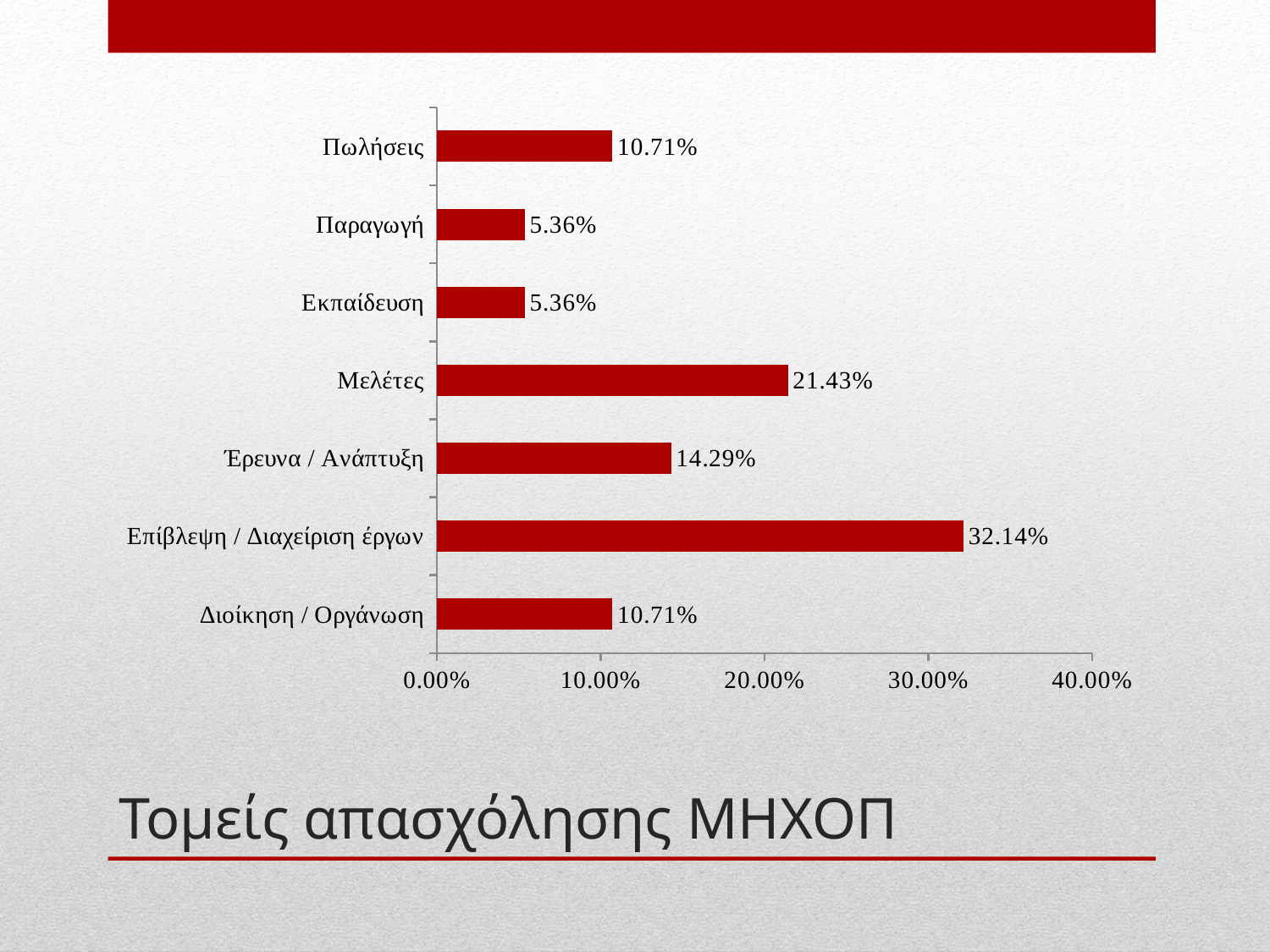
Which is larger, the value for Μελέτες or the value for Έρευνα / Ανάπτυξη? Μελέτες What is the value for Μελέτες? 21.43% Which category has the highest value? Επίβλεψη / Διαχείριση έργων What is the title of the slide? Τομείς απασχόλησης ΜΗΧΟΠ How many categories are shown in the chart? 7 Is the value for Επίβλεψη / Διαχείριση έργων greater or less than 30.00%? greater What is the value for Επίβλεψη / Διαχείριση έργων? 32.14% What is the value for Έρευνα / Ανάπτυξη? 14.29% What is the value for Πωλήσεις? 10.71% What kind of chart is shown on the slide? bar chart What is the difference between the values for Έρευνα / Ανάπτυξη and Παραγωγή? 8.93% What is the difference between the values for Επίβλεψη / Διαχείριση έργων and Μελέτες? 10.71%